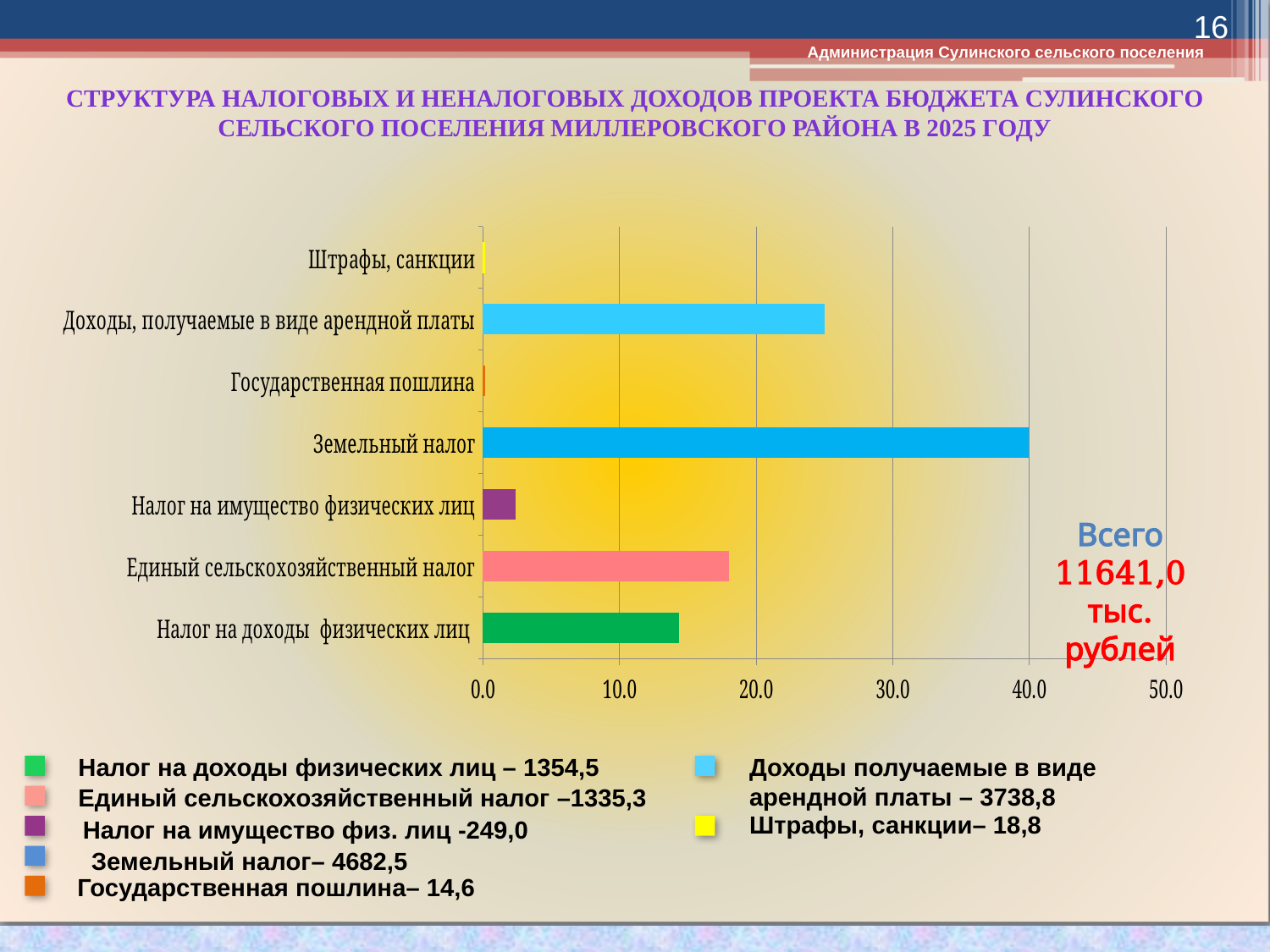
Which bar is longer: Земельный налог or Налог на доходы физических лиц? Земельный налог Is the value for Земельный налог greater or less than 30.0? greater Is the value for Единый сельскохозяйственный налог greater or less than 20.0? less How many categories are plotted in the bar chart? 7 What total (Всего) is printed next to the chart? 11641,0 тыс. рублей Which category has the longest bar in the chart? Земельный налог According to the legend below the chart, what amount is given for Земельный налог? 4682,5 Is the value for Налог на имущество физических лиц greater or less than 10.0? less Which bar is longer: Доходы, получаемые в виде арендной платы or Единый сельскохозяйственный налог? Доходы, получаемые в виде арендной платы What kind of chart is shown on the slide? bar chart